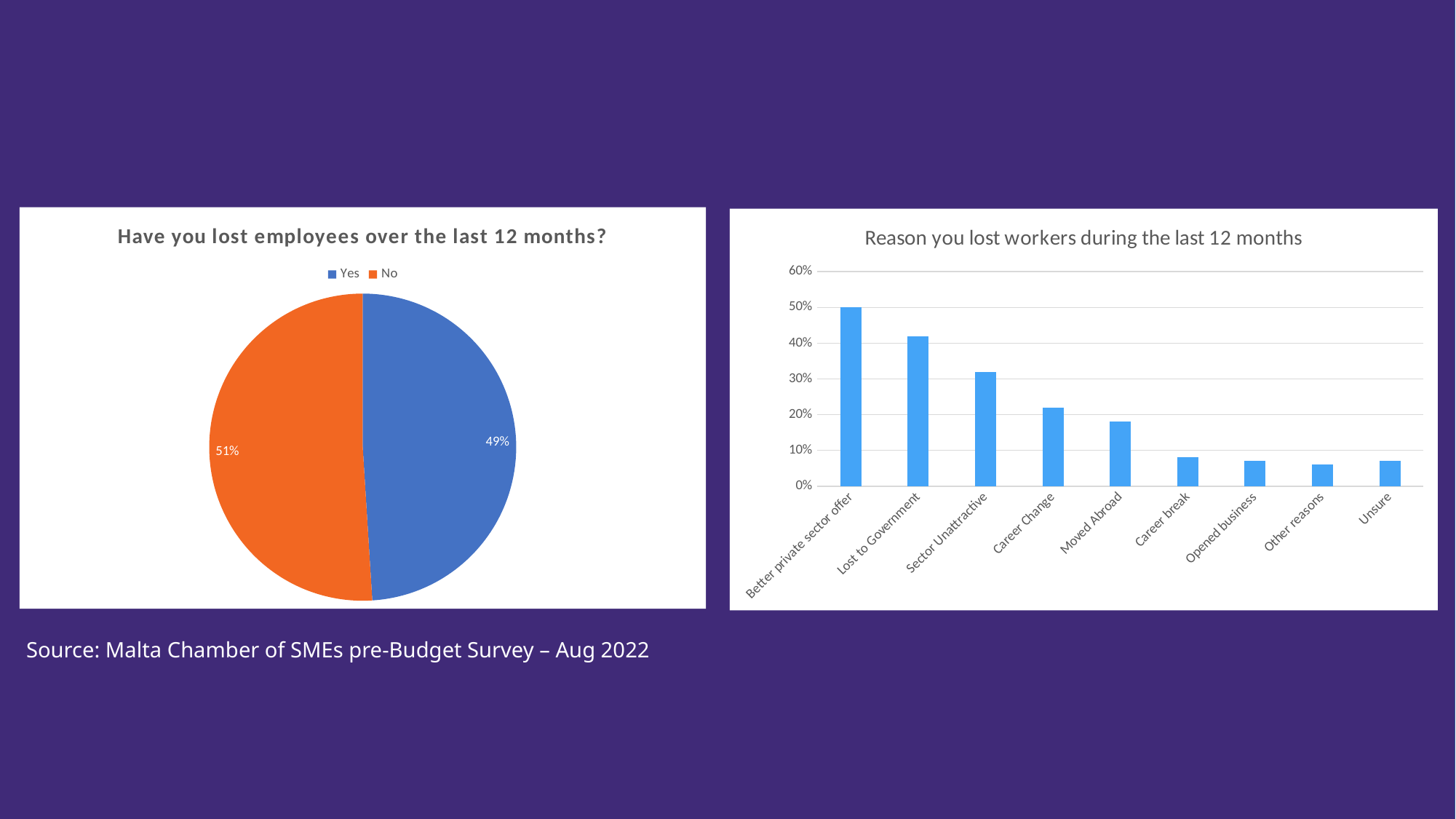
In the pie chart 'Have you lost employees over the last 12 months?', what percentage answered No? 51% In the pie chart 'Have you lost employees over the last 12 months?', which colour represents Yes? Blue In the bar chart 'Reason you lost workers during the last 12 months', is the value for Moved Abroad greater or less than 20%? less In the bar chart 'Reason you lost workers during the last 12 months', which is larger: Sector Unattractive or Career Change? Sector Unattractive What kind of chart is 'Reason you lost workers during the last 12 months'? Bar chart In the pie chart 'Have you lost employees over the last 12 months?', which answer has the larger share? No In the pie chart 'Have you lost employees over the last 12 months?', what is the difference in percentage points between No and Yes? 2 percentage points In the pie chart 'Have you lost employees over the last 12 months?', what percentage answered Yes? 49% How many entries does the legend of the pie chart 'Have you lost employees over the last 12 months?' list? 2 In the bar chart 'Reason you lost workers during the last 12 months', is the value for Lost to Government greater or less than 40%? greater How many categories are shown in the bar chart 'Reason you lost workers during the last 12 months'? 9 In the bar chart 'Reason you lost workers during the last 12 months', which reason has the highest value? Better private sector offer